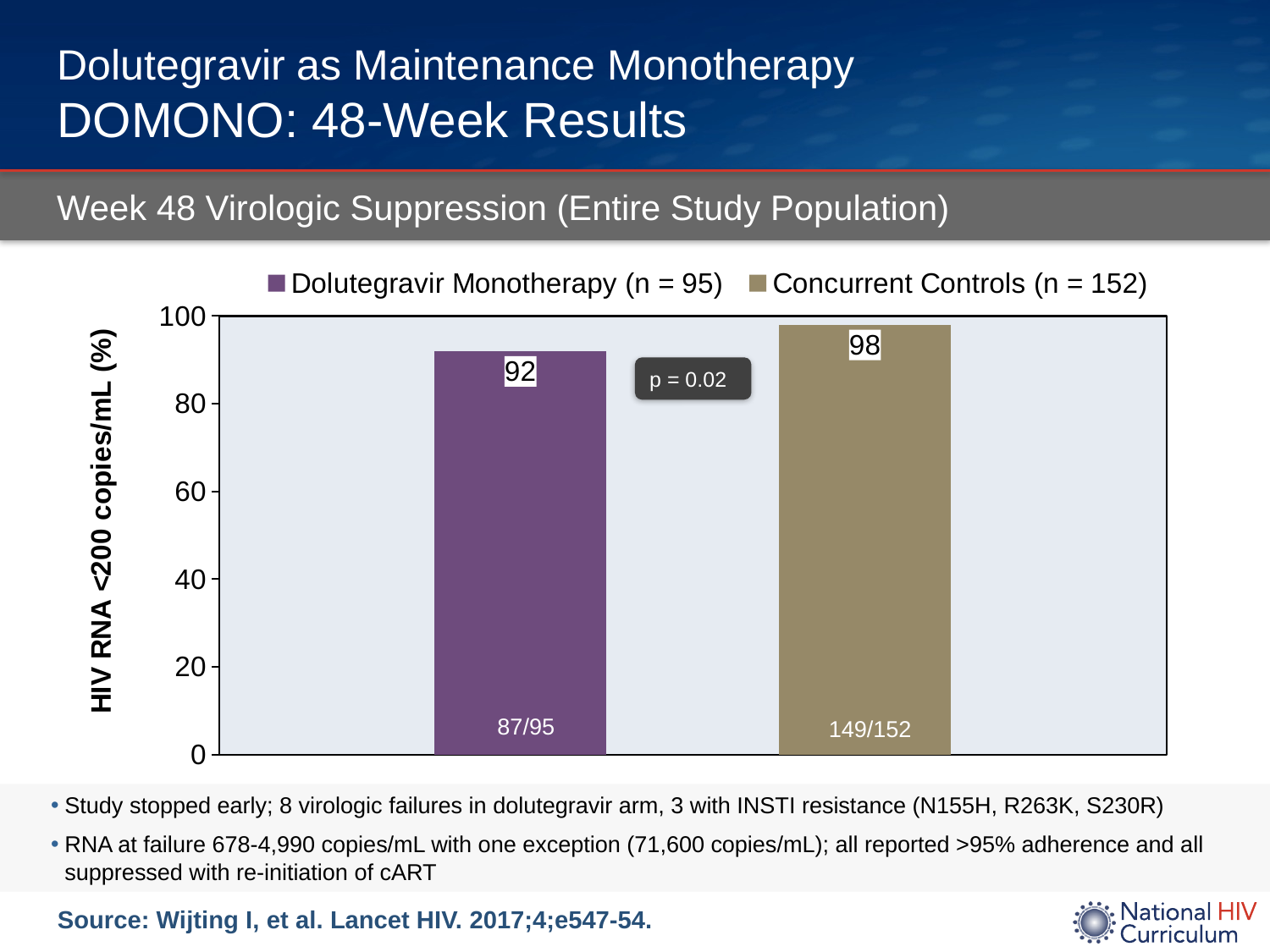
Is the value for Dolutegravir Monotherapy greater or less than 80? greater What fraction is printed inside the Dolutegravir Monotherapy bar? 87/95 What is the y-axis label of the chart? HIV RNA <200 copies/mL (%) Which series has the higher value, Dolutegravir Monotherapy or Concurrent Controls? Concurrent Controls What kind of chart is shown? Bar chart What p-value is shown on the chart? p = 0.02 What is the value for Concurrent Controls? 98 Which series has the lowest value? Dolutegravir Monotherapy What fraction is printed inside the Concurrent Controls bar? 149/152 What is the difference between the Concurrent Controls value and the Dolutegravir Monotherapy value? 6 What is the value for Dolutegravir Monotherapy? 92 How many series does the legend list? 2